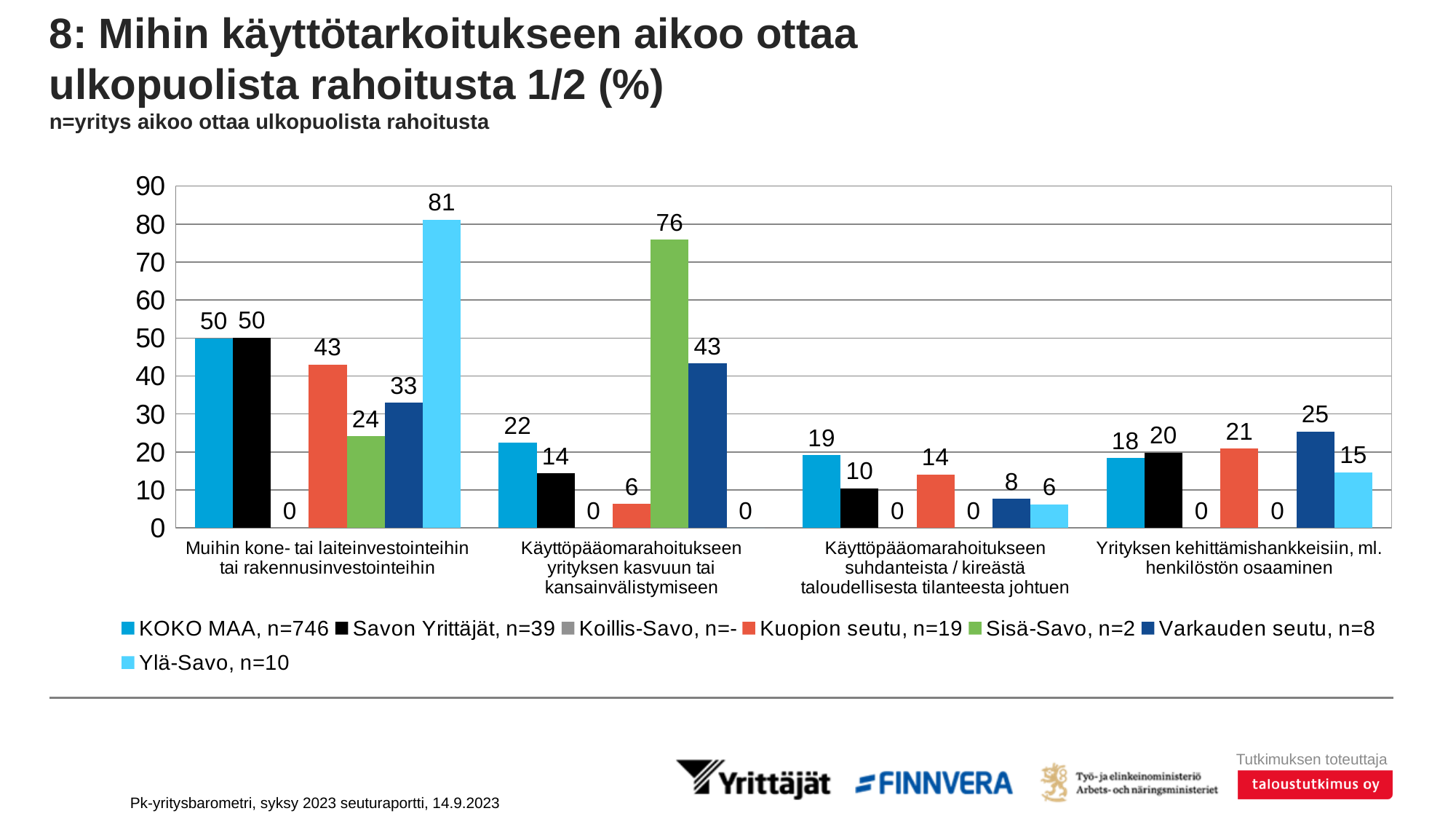
In which category does KOKO MAA, n=746 have its lowest value? Yrityksen kehittämishankkeisiin, ml. henkilöstön osaaminen Does the value for KOKO MAA, n=746 rise or fall from the first category to the last category along the x axis? Fall What kind of chart is shown on the slide? Bar chart What is the value for KOKO MAA, n=746 in the category "Käyttöpääomarahoitukseen suhdanteista / kireästä taloudellisesta tilanteesta johtuen"? 19 How many categories are shown on the x axis of the chart? 4 In the category "Yrityksen kehittämishankkeisiin, ml. henkilöstön osaaminen", which is larger: the value for Kuopion seutu, n=19 or the value for Savon Yrittäjät, n=39? Kuopion seutu, n=19 What is the value for Ylä-Savo, n=10 in the category "Muihin kone- tai laiteinvestointeihin tai rakennusinvestointeihin"? 81 What is the value for Sisä-Savo, n=2 in the category "Käyttöpääomarahoitukseen yrityksen kasvuun tai kansainvälistymiseen"? 76 Which series has the highest value in the category "Muihin kone- tai laiteinvestointeihin tai rakennusinvestointeihin"? Ylä-Savo, n=10 How many series does the legend list? 7 What is the difference between the Ylä-Savo, n=10 value and the Varkauden seutu, n=8 value in the category "Muihin kone- tai laiteinvestointeihin tai rakennusinvestointeihin"? 48 What is the value for Varkauden seutu, n=8 in the category "Yrityksen kehittämishankkeisiin, ml. henkilöstön osaaminen"? 25